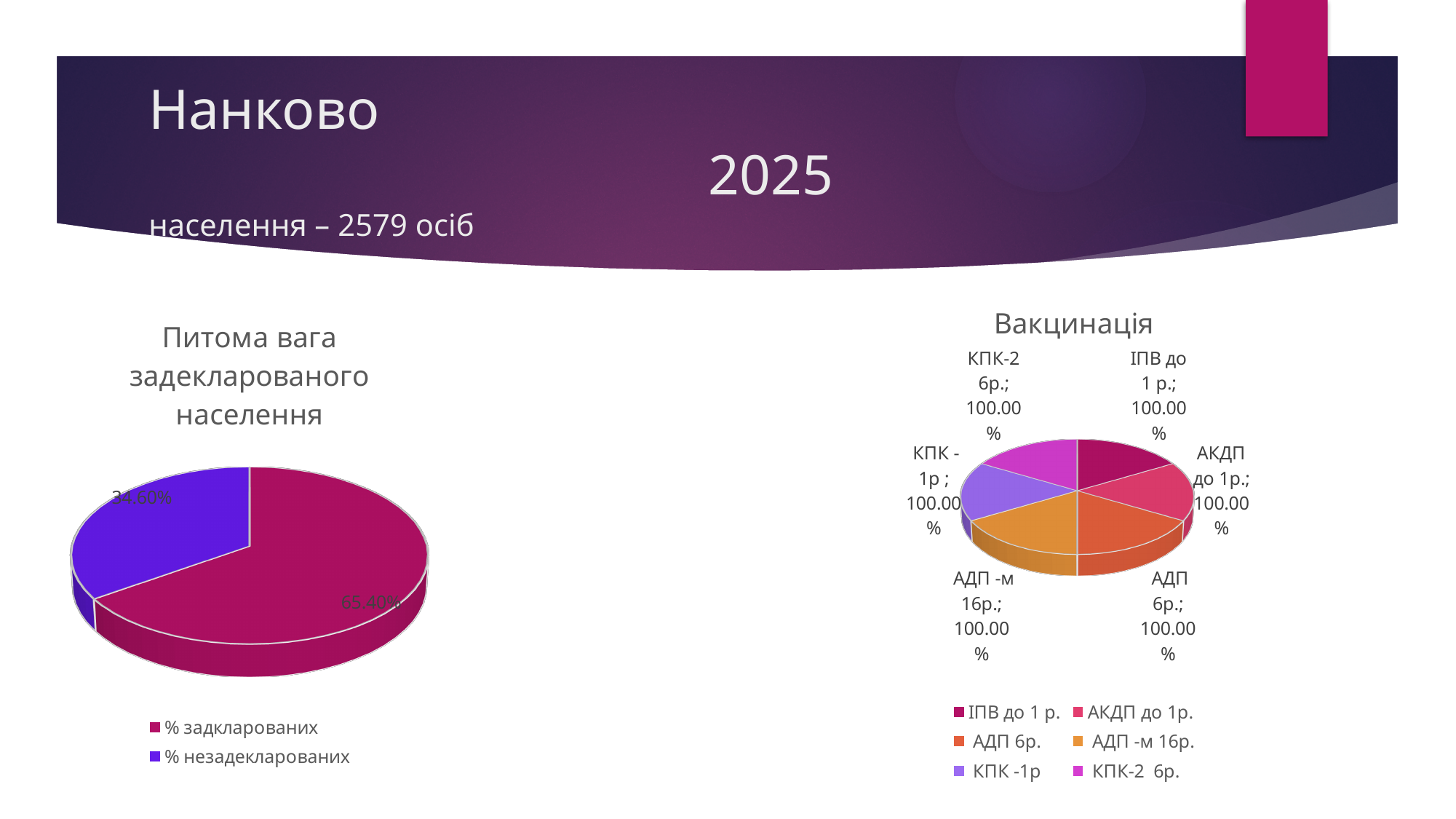
In the chart titled "Вакцинація", what is the value shown for "КПК-2 6р."? 100.00% What kind of chart is the chart titled "Питома вага задекларованого населення"? pie chart What kind of chart is the chart titled "Вакцинація"? pie chart In the chart titled "Питома вага задекларованого населення", what is the value for "% задклярованих"? 65.40% In the chart titled "Вакцинація", which legend entry is shown in orange? АДП -м 16р. In the chart titled "Вакцинація", how many slices does the pie have? 6 In the chart titled "Питома вага задекларованого населення", which category has the smallest slice? % незадекларованих In the chart titled "Питома вага задекларованого населення", how many entries does the legend list? 2 In the chart titled "Питома вага задекларованого населення", which category has the largest slice? % задклярованих In the chart titled "Питома вага задекларованого населення", what is the difference between the values for "% задклярованих" and "% незадекларованих"? 30.80% In the chart titled "Вакцинація", what is the value shown for "АДП 6р."? 100.00% In the chart titled "Питома вага задекларованого населення", what is the value for "% незадекларованих"? 34.60%